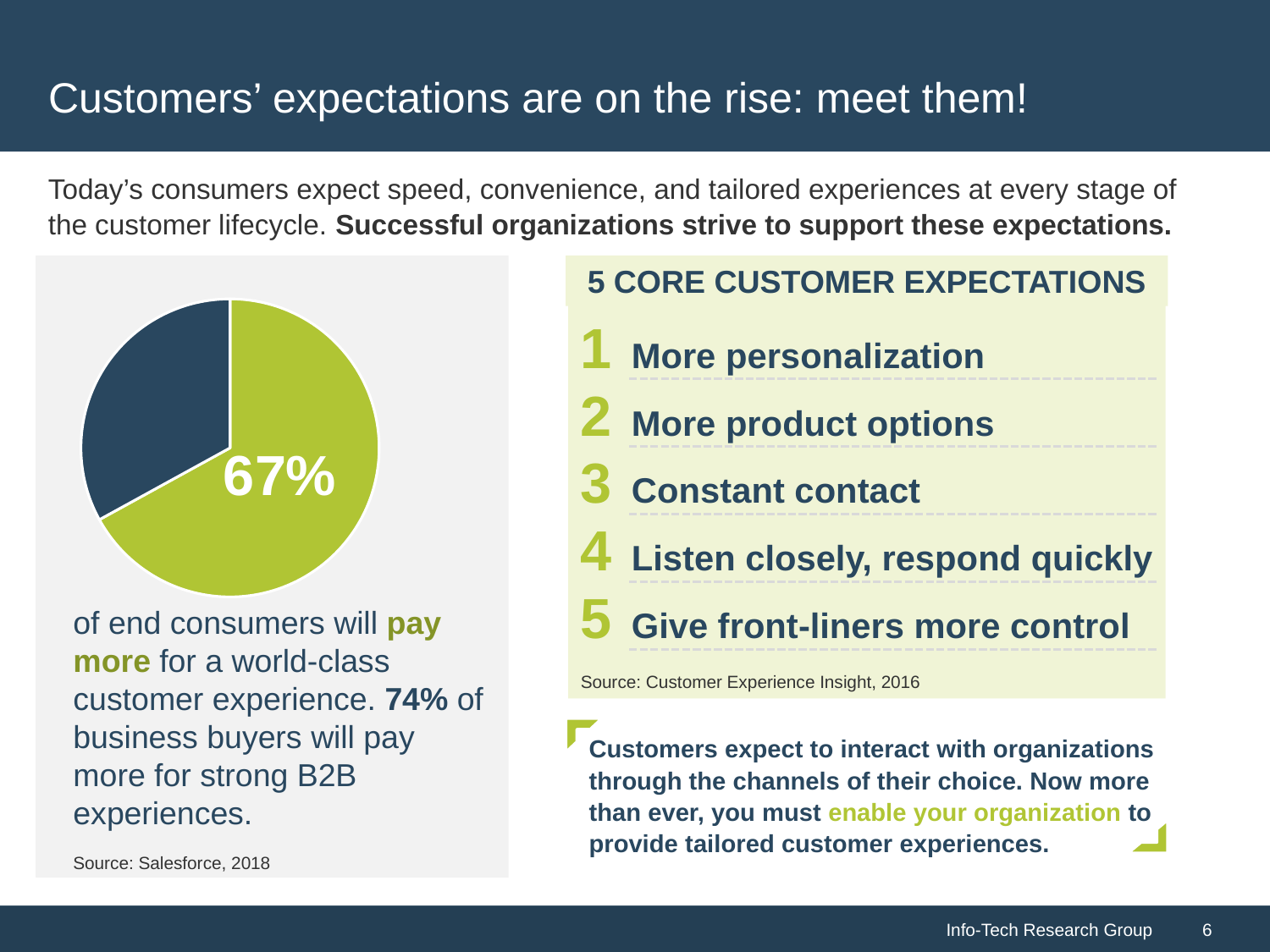
Which slice of the pie chart is the smallest? The dark blue slice How many slices does the pie chart have? 2 Which slice of the pie chart is larger, the green one or the dark blue one? The green one What percentage is printed on the large green slice of the pie chart? 67% What source is cited for the pie chart? Salesforce, 2018 Which slice of the pie chart is the largest? The green slice (67%) According to the text below the pie chart, what does the 67% represent? End consumers who will pay more for a world-class customer experience What share of the pie does the green slice represent? 67% What kind of chart is shown on the left side of the slide? Pie chart